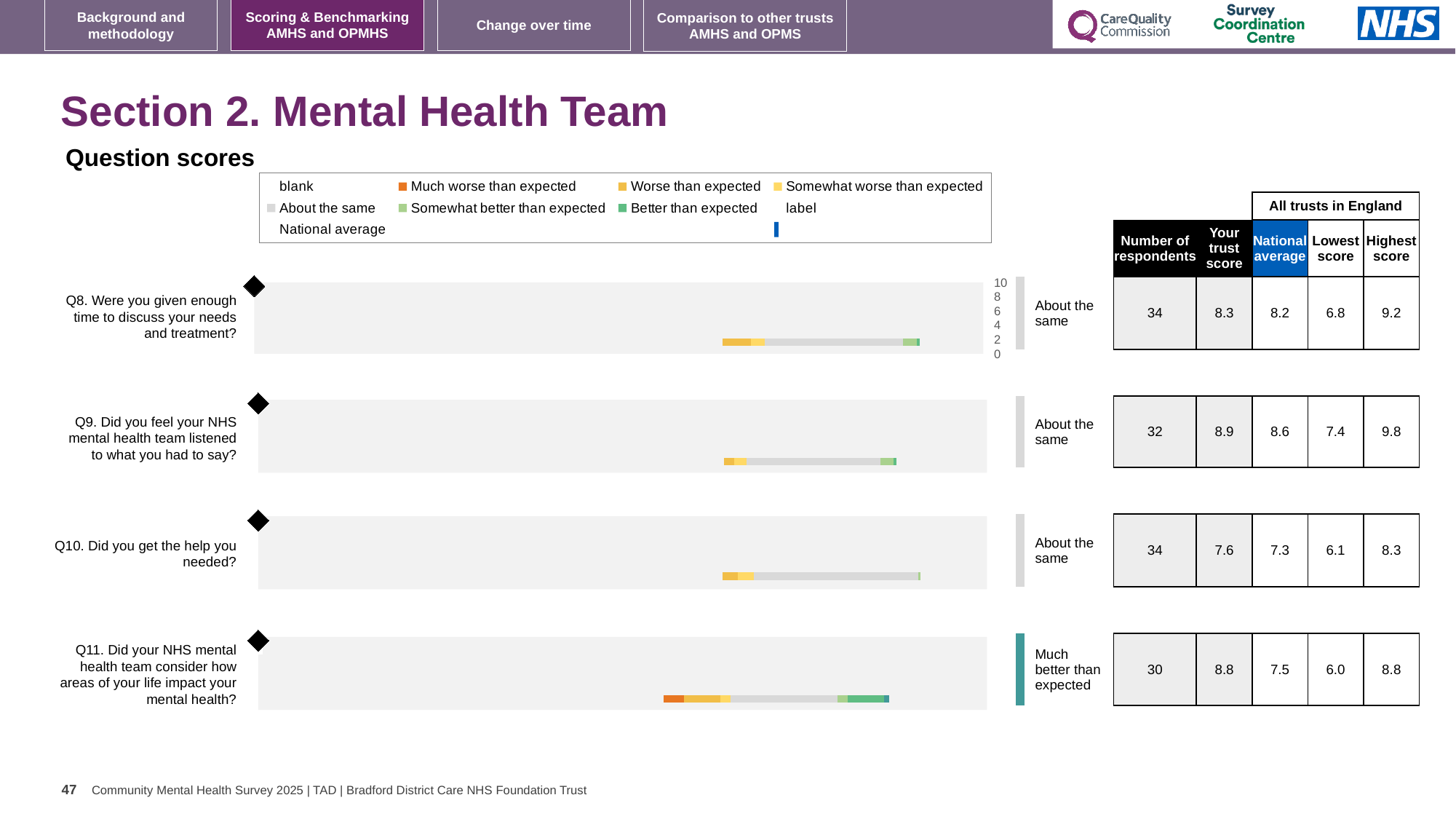
Which question has the highest 'Your trust score'? Q9 What colour represents 'Much worse than expected' in the legend? Orange What is the difference between the trust score and the national average for Q11? 1.3 What benchmark category is shown for Q11? Much better than expected What is the national average for Q9 (Did you feel your NHS mental health team listened to what you had to say)? 8.6 What is the 'Your trust score' value for Q8 (Were you given enough time to discuss your needs and treatment)? 8.3 How many respondents answered Q11 (Did your NHS mental health team consider how areas of your life impact your mental health)? 30 Which question has the lowest 'Your trust score'? Q10 How many questions (Q8 to Q11) are plotted on the slide? 4 What is the lowest score across all trusts in England for Q10 (Did you get the help you needed)? 6.1 For Q8, which is larger: the trust score or the national average? Your trust score (8.3) What kind of chart is used to show the question scores for Q8 to Q11? Bar chart